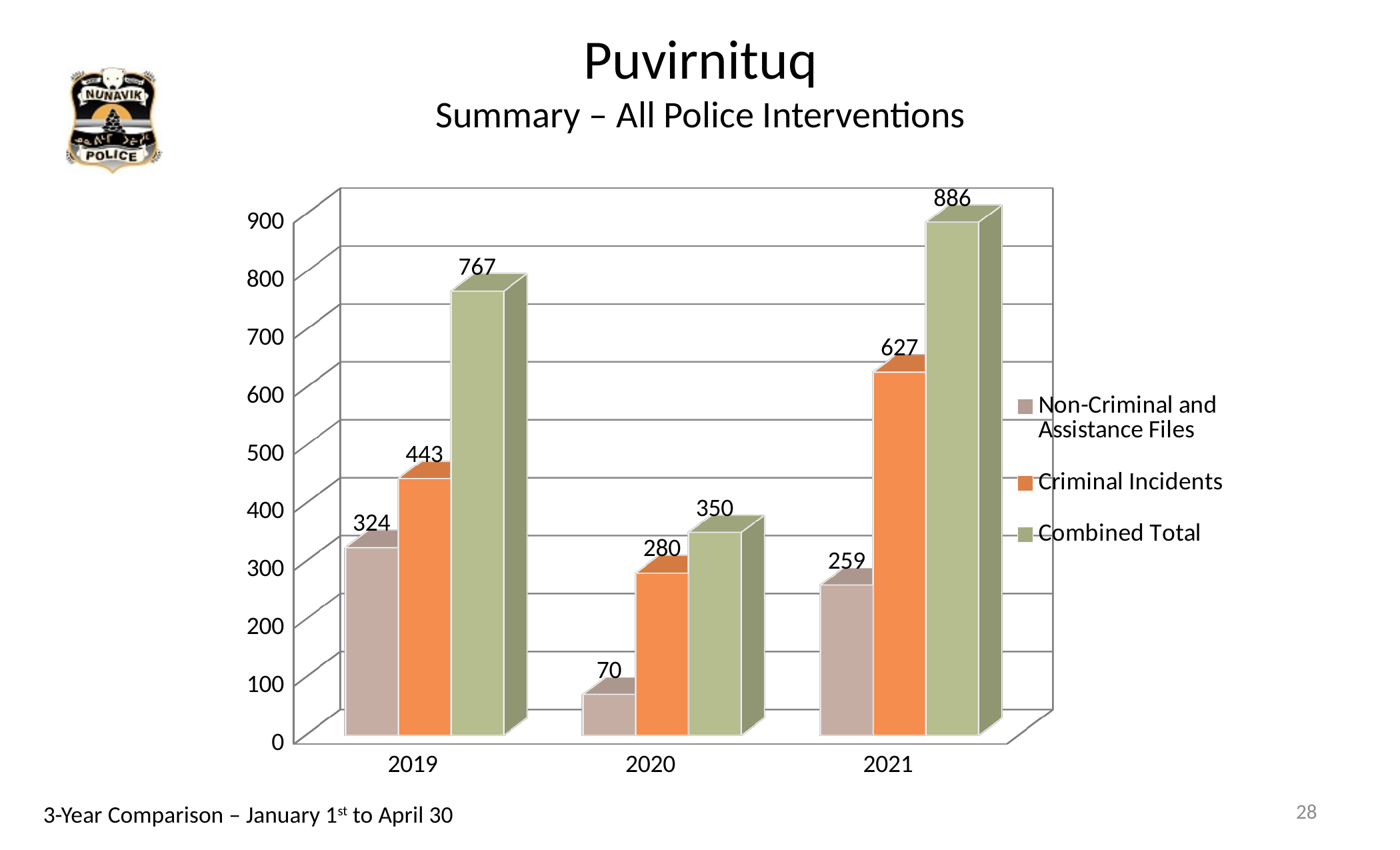
Which year has the highest Combined Total? 2021 What is the value of Criminal Incidents in 2021? 627 How many years are shown on the x axis? 3 Which colour represents Combined Total in the legend? Green What kind of chart is shown on the slide? Bar chart Which is larger: Criminal Incidents in 2019 or Criminal Incidents in 2020? Criminal Incidents in 2019 How many series does the legend list? 3 Which year has the lowest value for Non-Criminal and Assistance Files? 2020 What is the Combined Total for 2019? 767 What is the difference between the Combined Total in 2021 and in 2020? 536 What is the value of Non-Criminal and Assistance Files in 2020? 70 Do the Criminal Incidents values rise or fall from 2020 to 2021? Rise